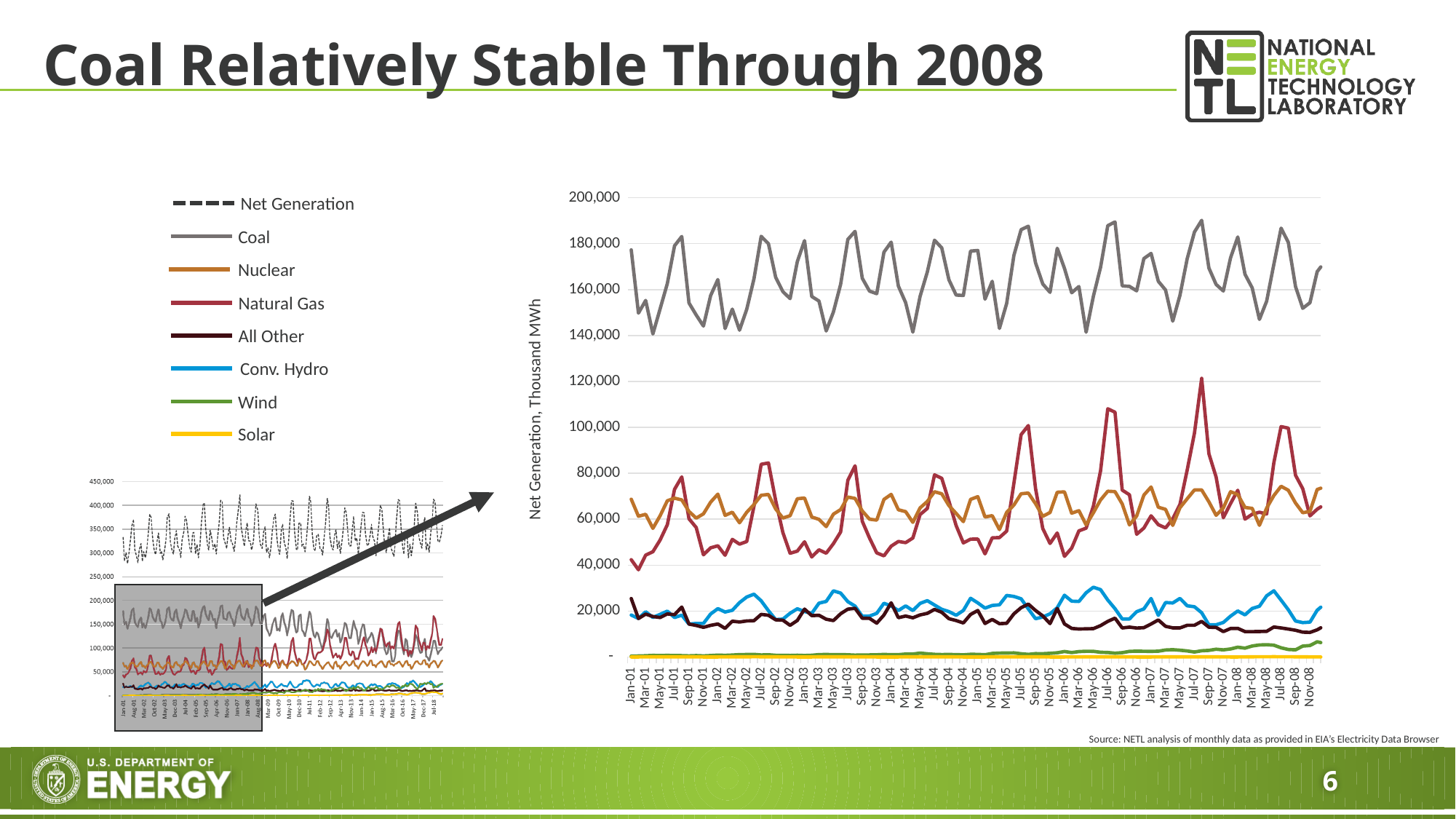
In the large chart on the right, is the value for Wind in Nov-08 greater or less than 20,000? less In the large chart on the right, which series has the highest values throughout? Coal In the large chart on the right, which series has the lowest values throughout? Solar What is the y-axis label of the large chart on the right? Net Generation, Thousand MWh In the large chart on the right, is the value for Coal in Jan-01 greater or less than 160,000? greater In the large chart on the right, is the peak value for Natural Gas in 2007 greater or less than 100,000? greater What kind of chart is the large chart on the right of the slide? line chart In the large chart on the right, which series is higher throughout, Coal or Nuclear? Coal How many series does the legend on the slide list? 8 In the large chart on the right, do the summer peaks of Natural Gas rise or fall from 2001 to 2007? rise Which series is shown with a dashed line in the legend? Net Generation